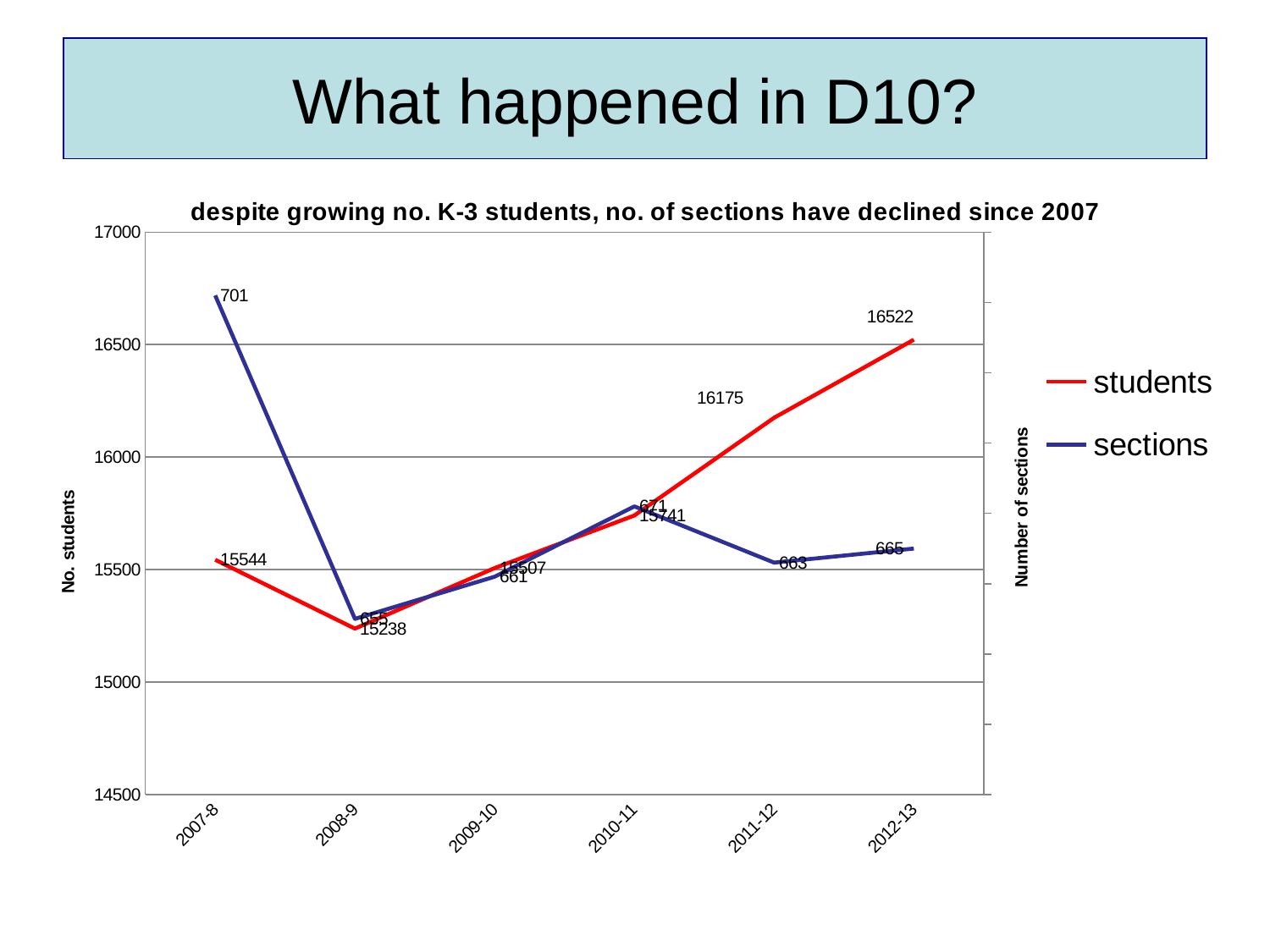
In which school year is the number of students lowest? 2008-9 What is the number of sections in 2011-12? 663 What is the number of students in 2012-13? 16522 In which school year is the number of students highest? 2012-13 Which year has more sections, 2007-8 or 2012-13? 2007-8 What is the number of sections in 2007-8? 701 How many series does the legend list? 2 What is the title of the chart? despite growing no. K-3 students, no. of sections have declined since 2007 What is the number of students in 2008-9? 15238 What is the difference in the number of students between 2012-13 and 2007-8? 978 What type of chart is shown on the slide? line chart How many school years are plotted along the x axis? 6